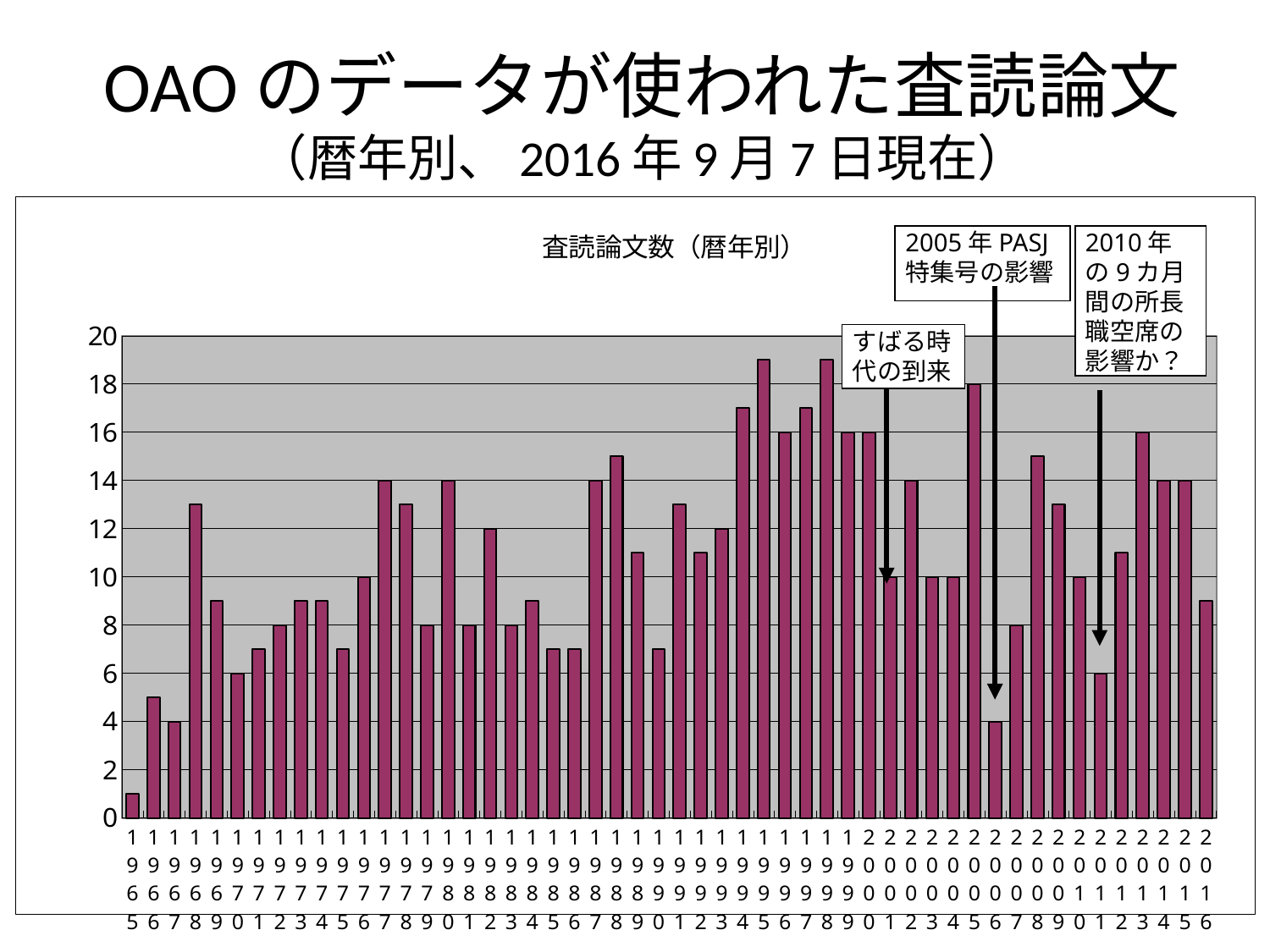
What is the difference between the values for 2005 and 2006? 14 What is the value for 1982? 12 What is the value for 2006? 4 Is the value for 1994 greater or less than 14? greater Which year has the lowest number of papers? 1965 What kind of chart is shown on the slide? bar chart Does the value rise or fall from 2005 to 2006? fall Which is larger, the value for 1968 or the value for 1970? 1968 What is the value for 2011? 6 How many years (bars) are plotted in the chart? 52 What is the title printed above the chart's plot area? 査読論文数（暦年別） What is the value for 2005? 18